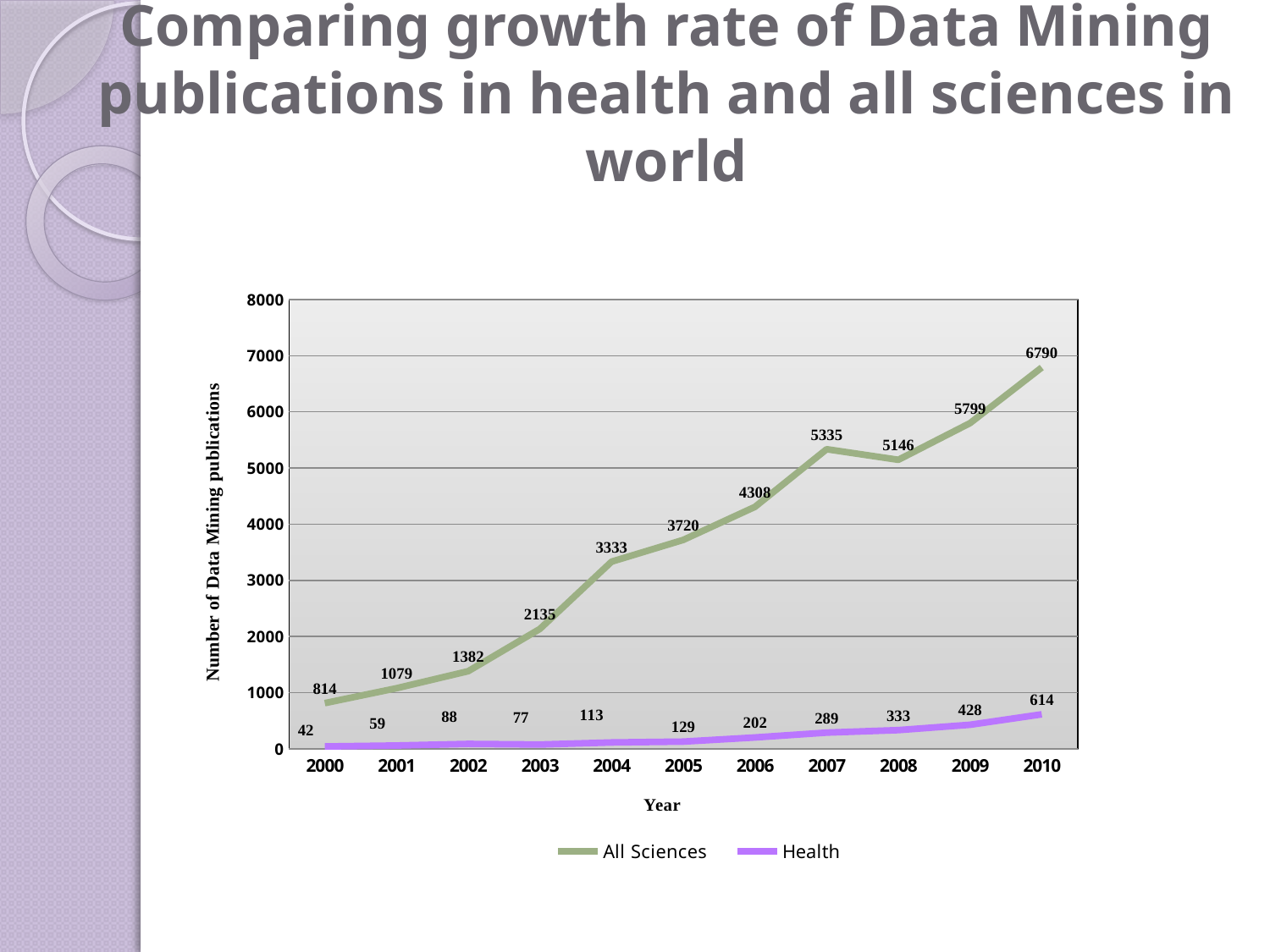
How many years are shown on the x axis? 11 How many series does the legend list? 2 What is the difference between the Health values in 2003 and 2002? 11 In which year is the All Sciences value highest? 2010 In which year is the Health value lowest? 2000 What kind of chart is shown on the slide? line chart Which is larger, the All Sciences value in 2007 or in 2008? 2007 What is the label of the y axis? Number of Data Mining publications What is the value for All Sciences in 2004? 3333 Does the Health series generally rise or fall from 2000 to 2010? rise What is the value for Health in 2009? 428 What is the difference between the All Sciences and Health values in 2010? 6176